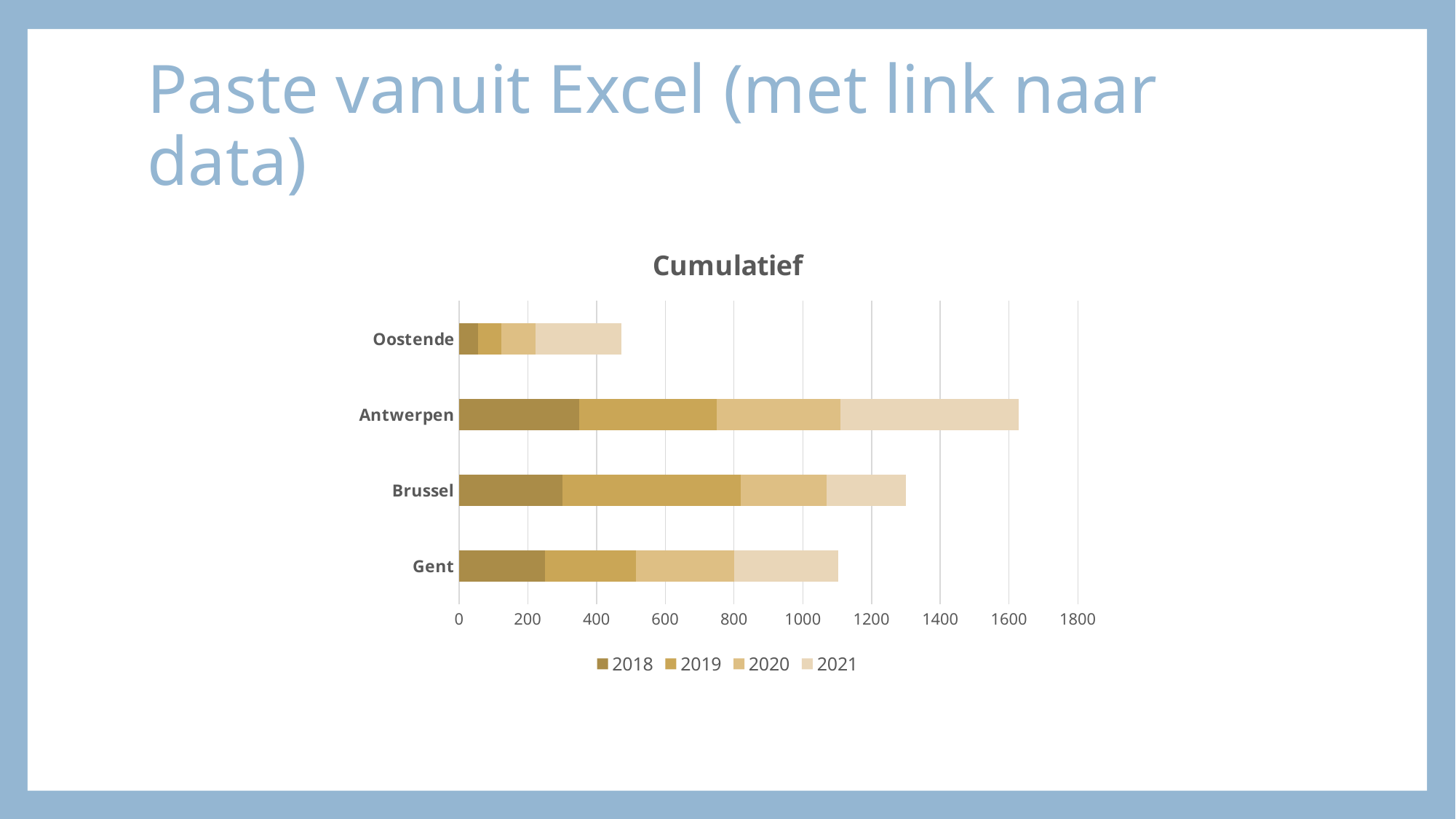
Which category has the shortest total bar? Oostende Which has a larger total bar, Brussel or Gent? Brussel How many categories are shown on the vertical axis? 4 Which has a larger total bar, Antwerpen or Brussel? Antwerpen Which category has the longest total bar? Antwerpen Is the total bar for Oostende greater or less than 600? less Is the total bar for Gent greater or less than 1000? greater Which years are listed in the legend? 2018, 2019, 2020, 2021 What is the title of the chart? Cumulatief Is the total bar for Antwerpen greater or less than 1400? greater How many series does the legend list? 4 What kind of chart is shown on the slide? Stacked bar chart